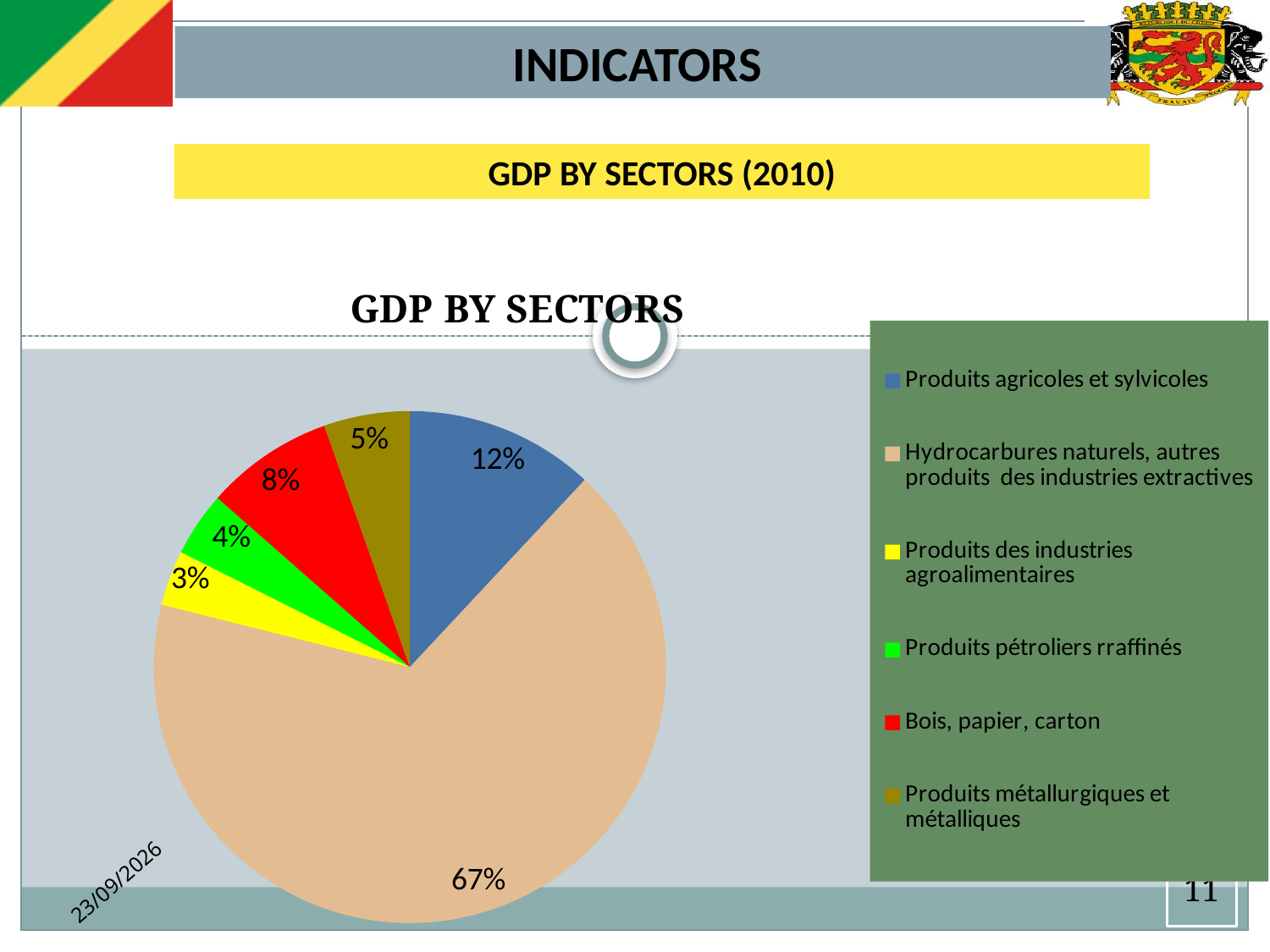
What share of GDP is attributed to Produits agricoles et sylvicoles? 12% What share of GDP is attributed to Produits pétroliers rraffinés? 4% Which sector has the largest share of GDP? Hydrocarbures naturels, autres produits des industries extractives How many sectors are shown in the pie chart? 6 Which sector has the smallest share of GDP? Produits des industries agroalimentaires What share of GDP is attributed to Produits des industries agroalimentaires? 3% What kind of chart is shown on the slide? pie chart What is the chart's title? GDP BY SECTORS What is the difference in percentage points between the share for Produits agricoles et sylvicoles and the share for Bois, papier, carton? 4